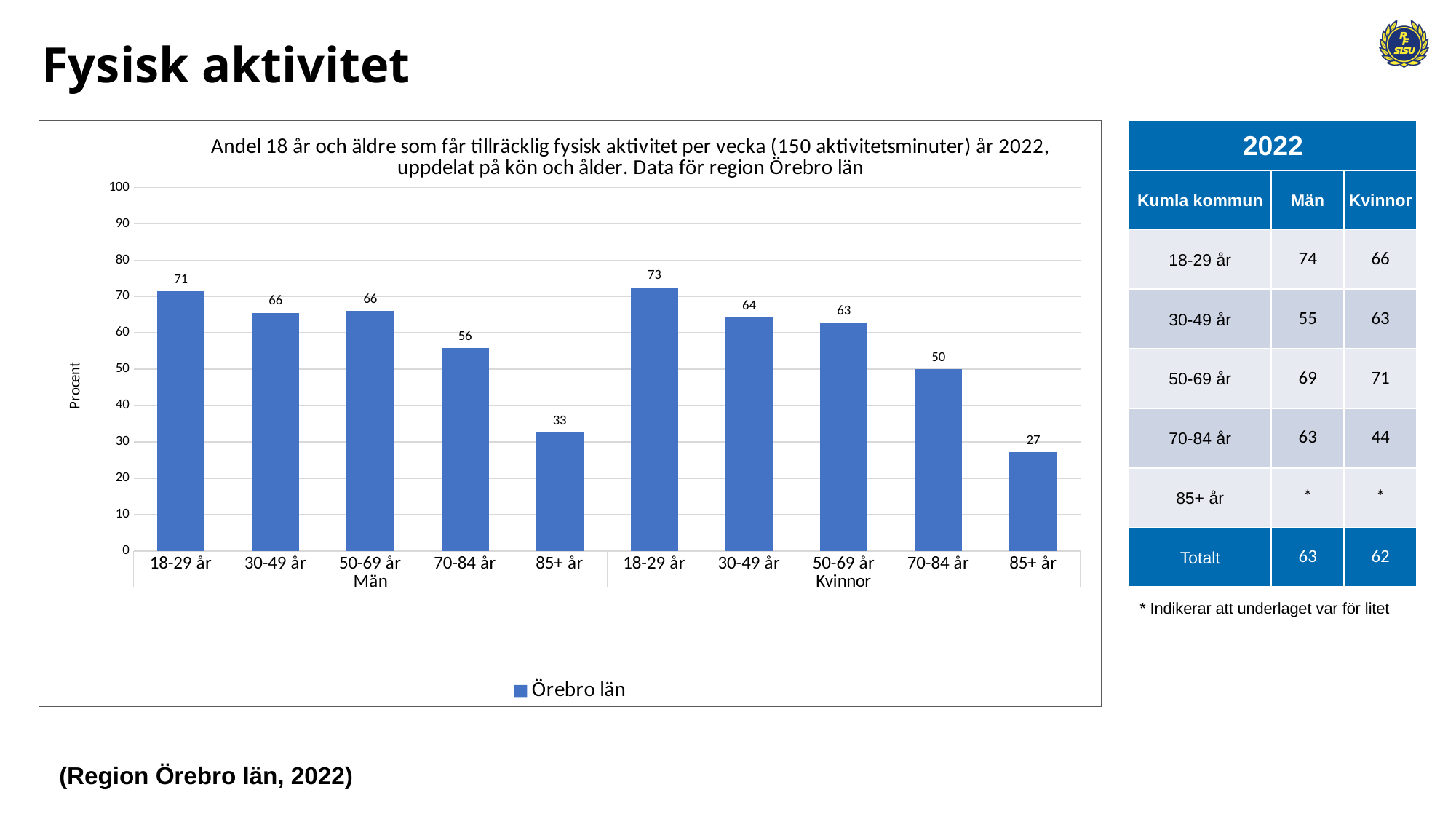
Which bar in the chart has the highest value? Kvinnor 18-29 år Which bar in the chart has the lowest value? Kvinnor 85+ år What is the value for women aged 85+ år in the chart? 27 What is the name of the series in the chart legend? Örebro län What is the value for women aged 70-84 år in the chart? 50 What is the difference between the values for men aged 18-29 år and men aged 85+ år? 38 How many bars are plotted in the chart? 10 What kind of chart is shown on the slide? Bar chart How many series does the chart legend list? 1 Is the value for men aged 85+ år greater or less than 40? less What is the value for men aged 18-29 år in the chart? 71 Which is larger in the chart: the value for men aged 70-84 år or women aged 70-84 år? Men aged 70-84 år